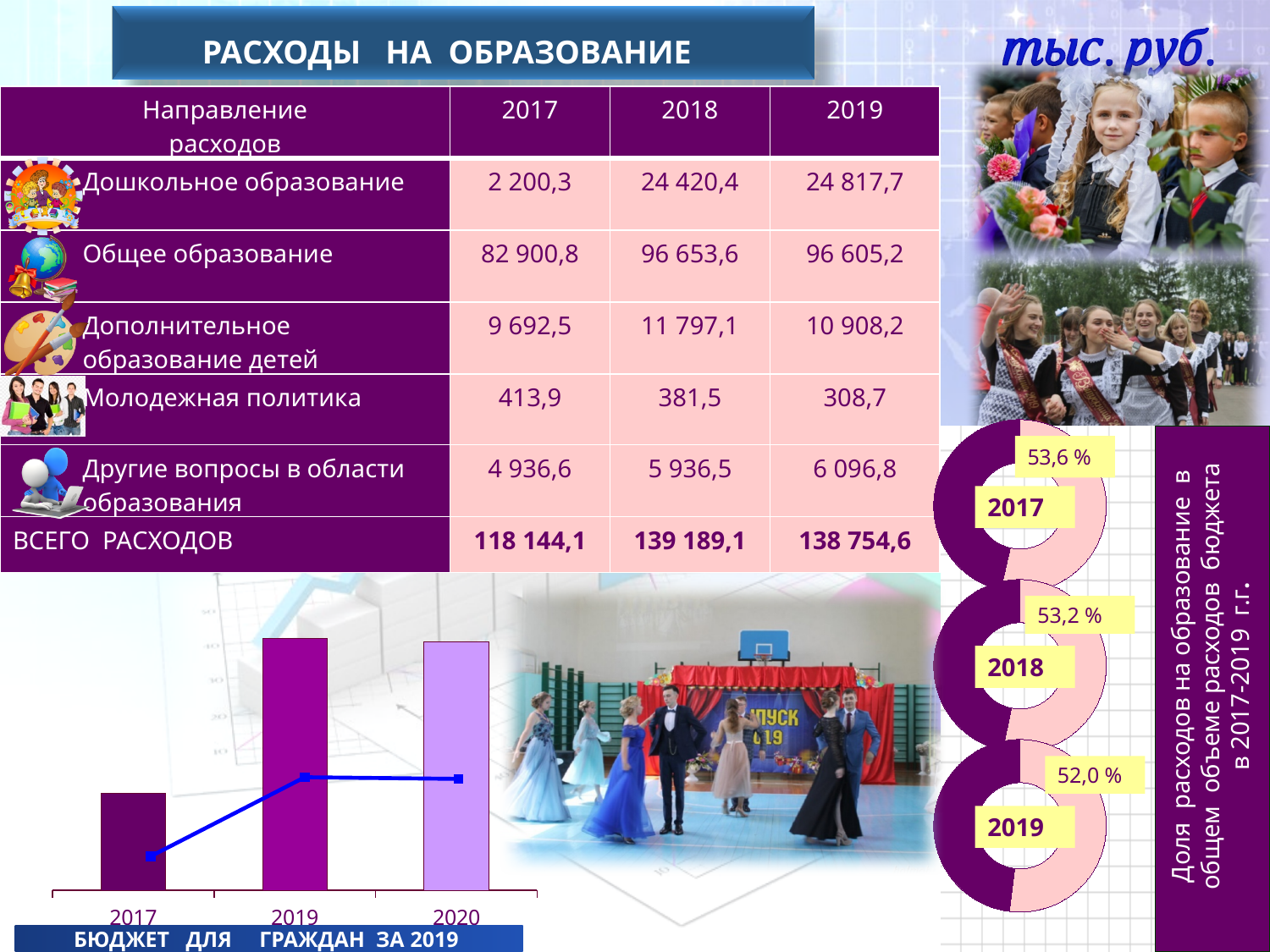
Among the donut charts on the right, which year has the lowest share of education expenses? 2019 In the donut charts on the right, what is the share of education expenses for 2018? 53,2 % How many donut charts are shown on the right side of the slide? 3 In the donut charts on the right, by how many percentage points does the 2017 share exceed the 2019 share? 1,6 % In the bar chart at the bottom left, which year has the tallest bar? 2019 In the donut charts on the right, what is the share of education expenses for 2019? 52,0 % Among the donut charts on the right, which year has the highest share of education expenses? 2017 What kind of chart is shown at the bottom left of the slide? bar chart with a line In the donut charts on the right, is the share for 2018 larger or smaller than the share for 2019? larger In the donut charts on the right showing the share of education expenses in the total budget, what is the share for 2017? 53,6 % Looking at the donut charts on the right, does the share of education expenses rise or fall from 2017 to 2019? fall In the bar chart at the bottom left, how many years are shown on the x axis? 3